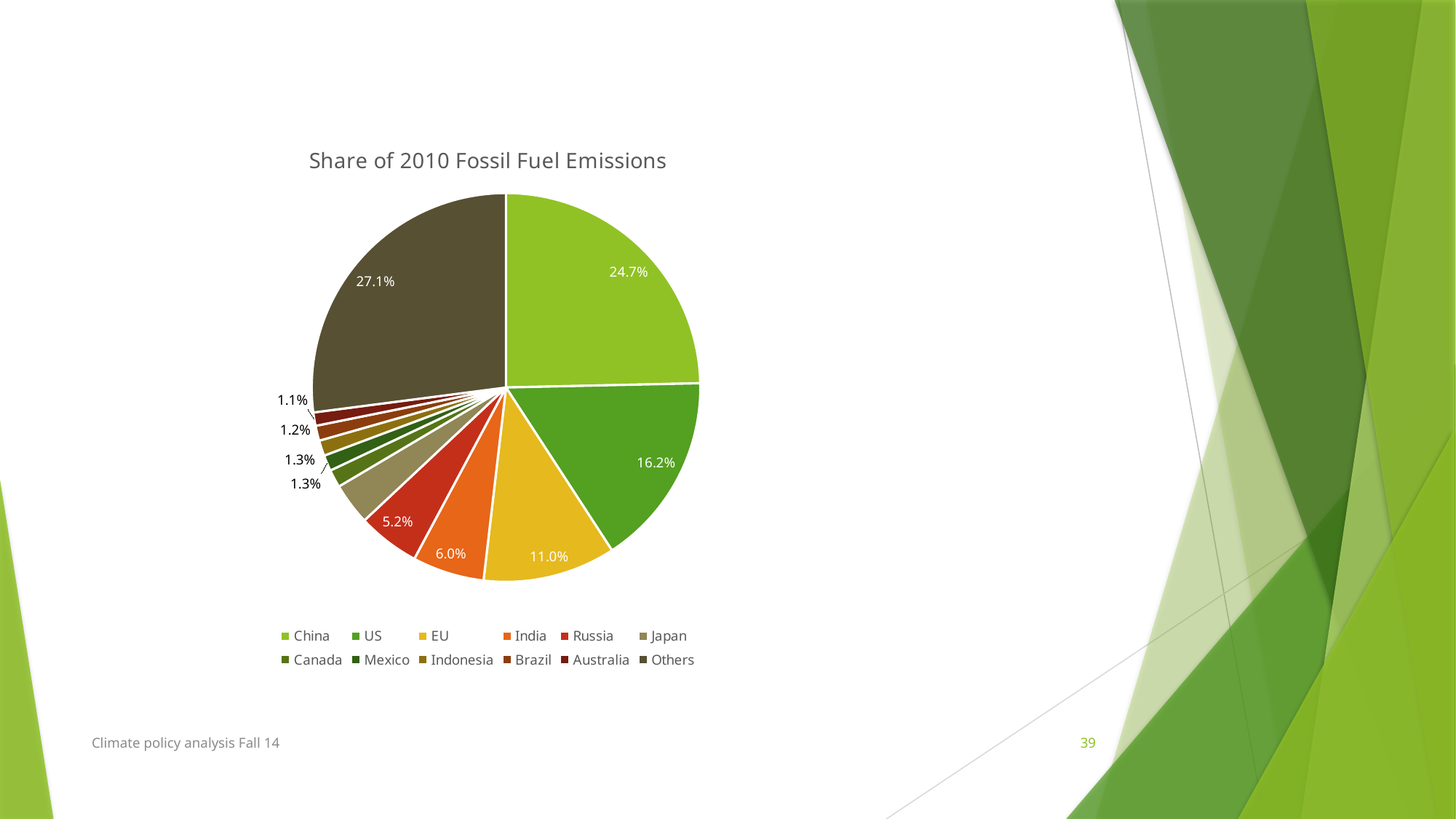
What share of 2010 fossil fuel emissions is attributed to Russia? 5.2% What share of 2010 fossil fuel emissions is attributed to the US? 16.2% How many categories does the legend list? 12 What share of 2010 fossil fuel emissions is attributed to Others? 27.1% What type of chart is shown on the slide? Pie chart What is the title of the chart? Share of 2010 Fossil Fuel Emissions Which has a larger share of 2010 fossil fuel emissions, the EU or India? EU What is the difference in percentage points between China's share and the US share? 8.5 percentage points What share of 2010 fossil fuel emissions is attributed to the EU? 11.0% What share of 2010 fossil fuel emissions is attributed to India? 6.0% Which slice of the pie is the largest? Others What share of 2010 fossil fuel emissions is attributed to China? 24.7%